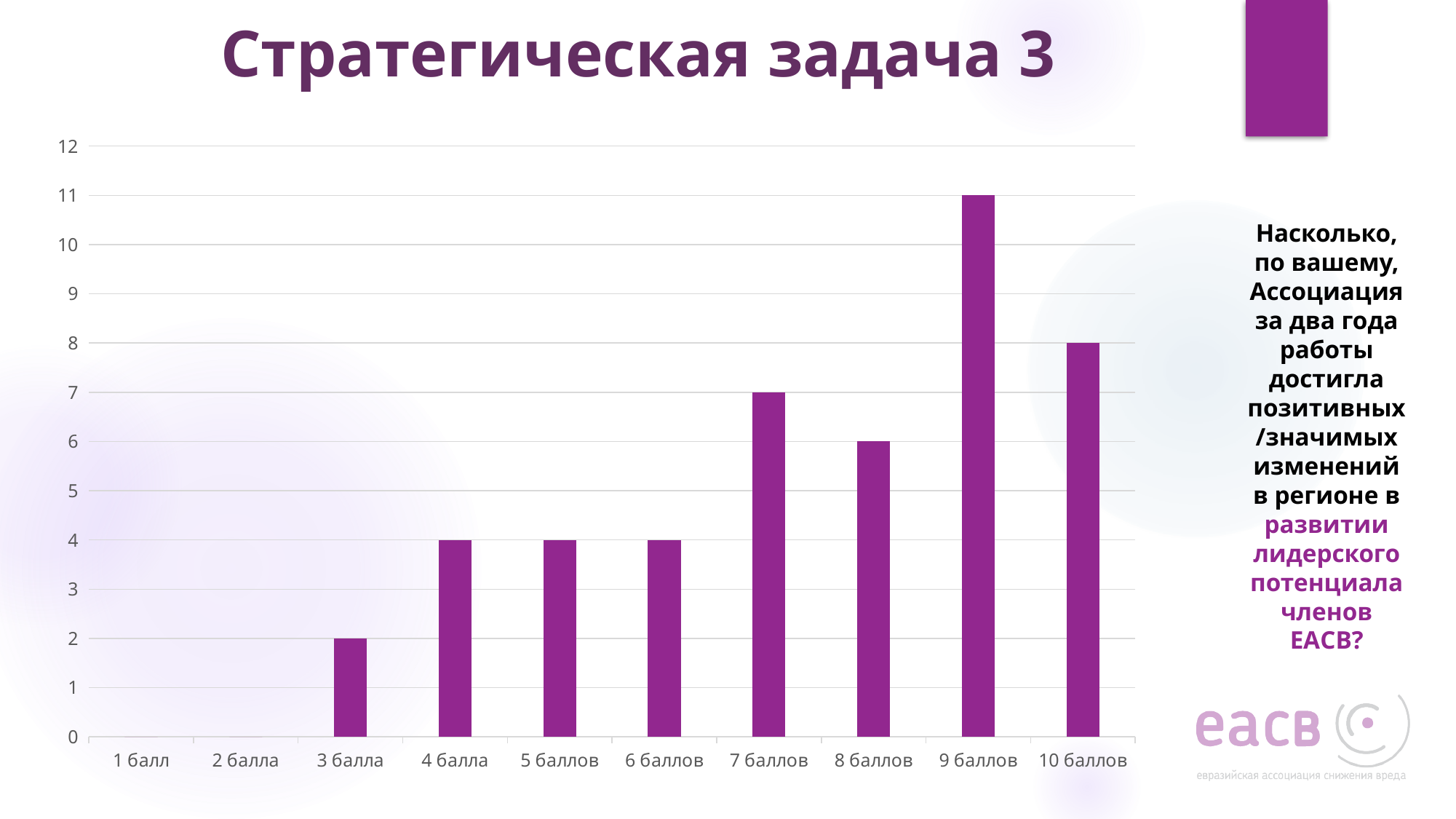
What is the value for 9 баллов? 11 What kind of chart is shown on the slide? bar chart What is the difference between the values for 9 баллов and 10 баллов? 3 What is the value for 10 баллов? 8 What is the value for 7 баллов? 7 Which is larger, the value for 7 баллов or the value for 8 баллов? 7 баллов Which categories have no visible bar in the chart? 1 балл and 2 балла What is the title of the slide containing the chart? Стратегическая задача 3 Which category has the highest bar in the chart? 9 баллов How many categories are shown on the x axis of the chart? 10 Is the value for 8 баллов greater or less than 5? greater What is the value for 3 балла? 2